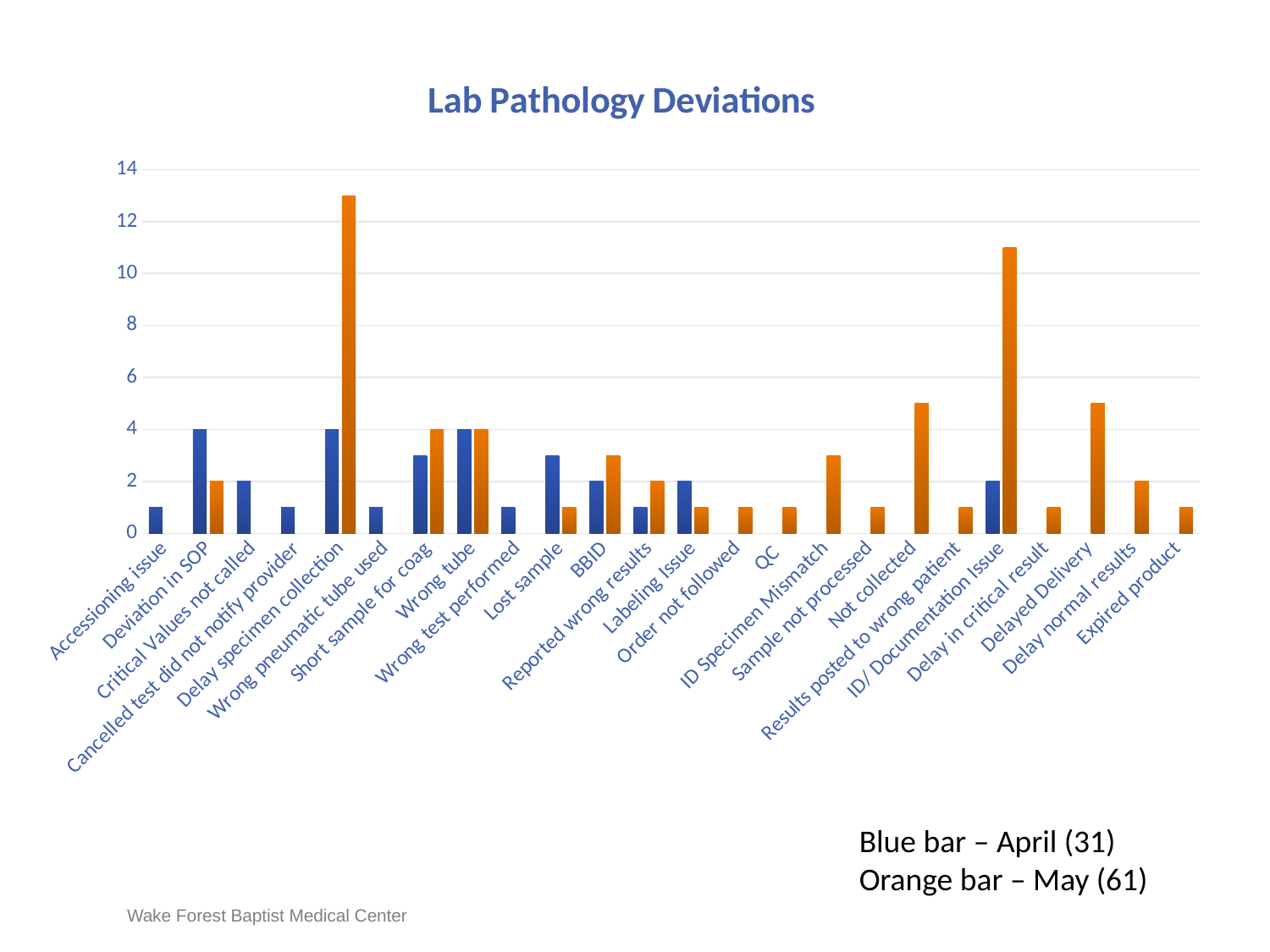
What is the value of the blue (April) bar for Critical Values not called? 2 What is the title of the chart? Lab Pathology Deviations For Delay specimen collection, which bar is larger, the blue (April) bar or the orange (May) bar? orange (May) Is the orange (May) value for ID/ Documentation Issue greater or less than 10? greater What is the value of the orange (May) bar for Delay normal results? 2 Which category has the highest orange (May) bar? Delay specimen collection What kind of chart is shown on the slide? bar chart What is the value of the blue (April) bar for Deviation in SOP? 4 How many categories are shown on the x axis of the chart? 24 Is the orange (May) value for Delay specimen collection greater or less than 12? greater What is the value of the orange (May) bar for Wrong tube? 4 What is the difference between the blue (April) bar for Wrong tube and the orange (May) bar for Deviation in SOP? 2